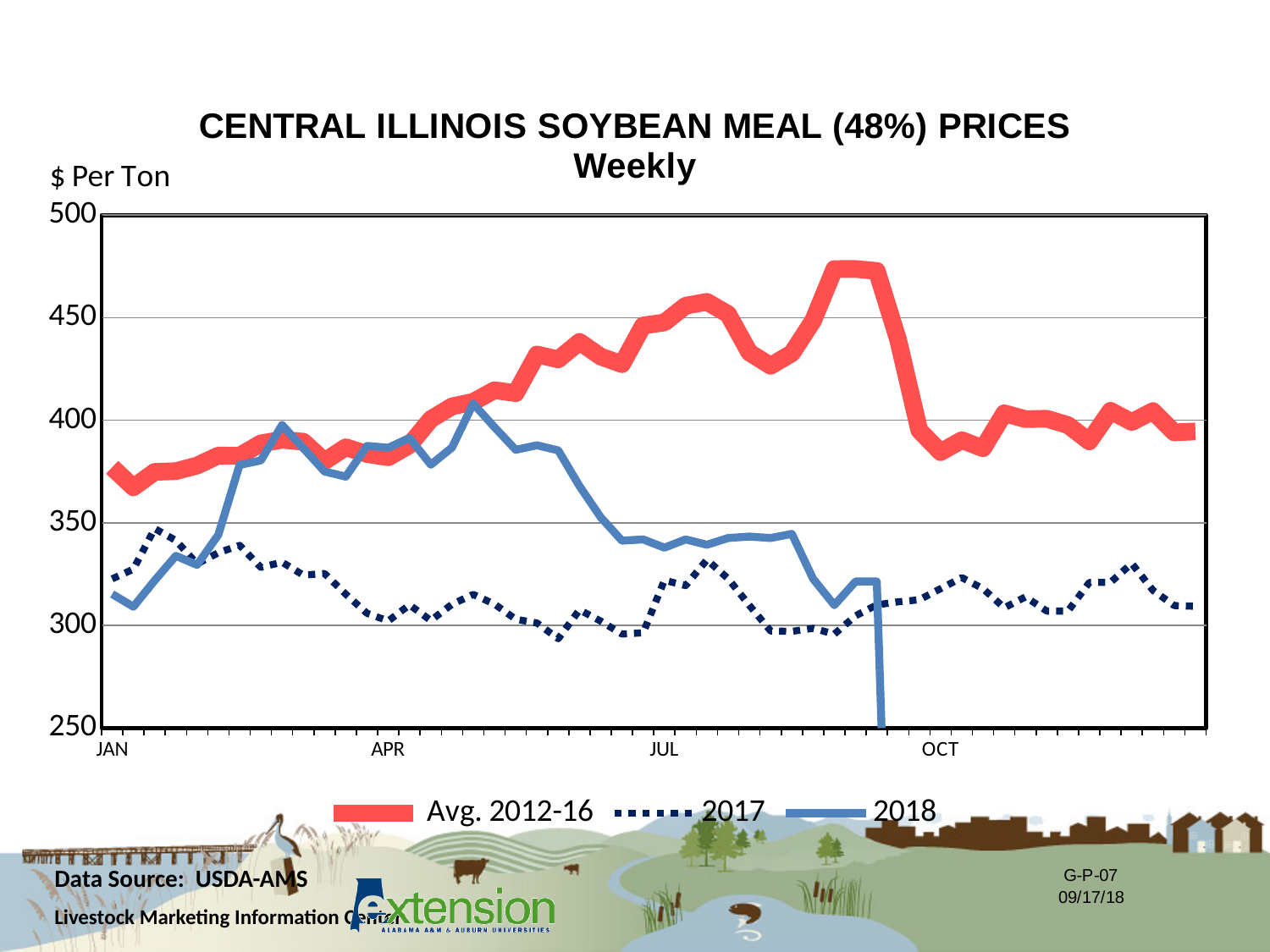
What is the title of the chart? CENTRAL ILLINOIS SOYBEAN MEAL (48%) PRICES Weekly Which series has the lowest value at JUL? 2017 What kind of chart is shown on the slide? line chart Does the Avg. 2012-16 series rise or fall from JAN to JUL? rise What unit is shown on the y axis label? $ Per Ton Is the value for Avg. 2012-16 at JAN greater or less than 350? greater At APR, which is higher: 2018 or 2017? 2018 How many series does the legend list? 3 At JUL, which is higher: Avg. 2012-16 or 2017? Avg. 2012-16 Is the value for 2017 at JAN greater or less than 350? less Is the value for 2018 at JUL greater or less than 400? less